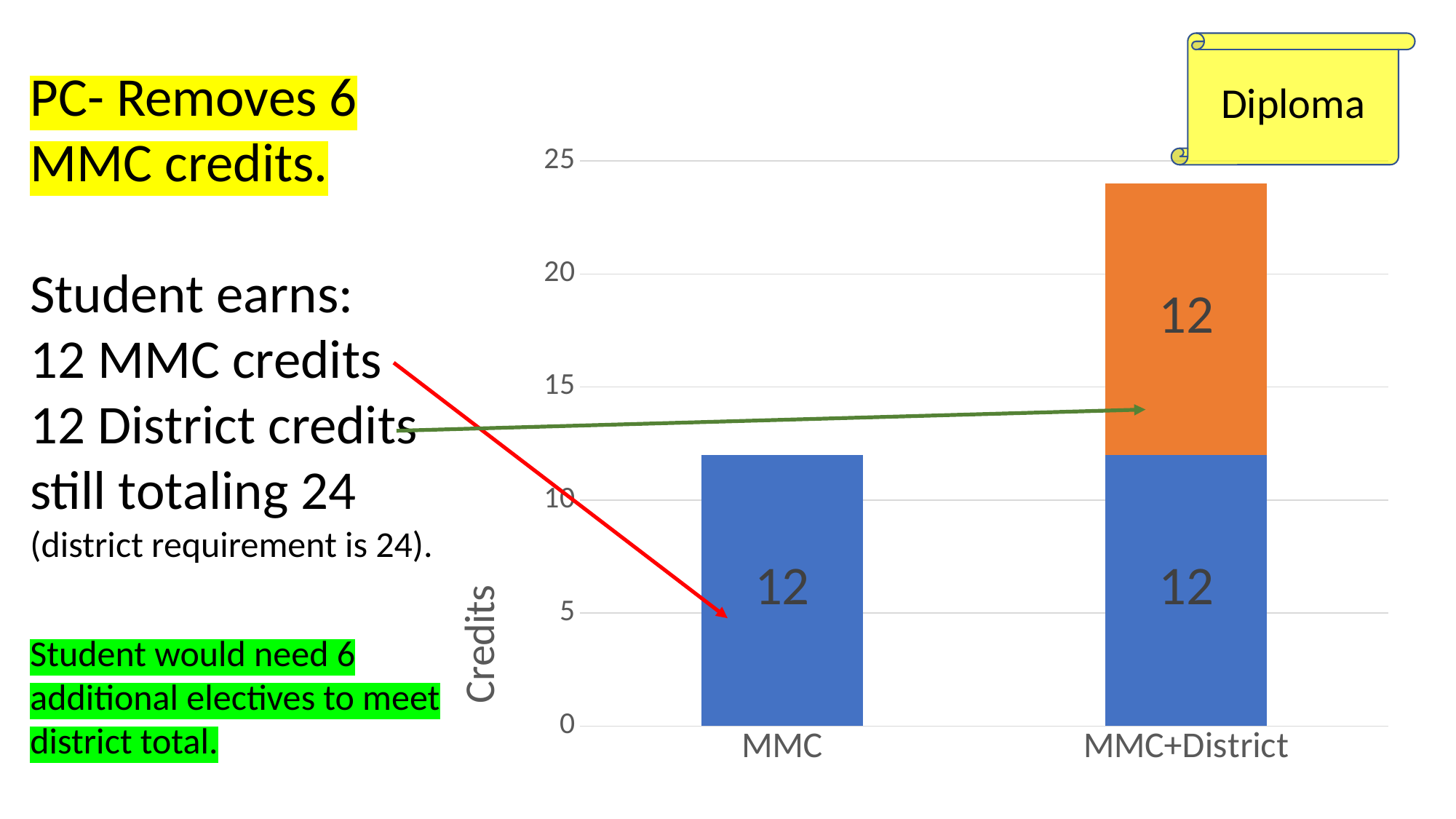
What kind of chart is shown on the slide? bar chart What is the difference between the total of the MMC+District bar and the MMC bar? 12 Is the value of the MMC bar greater or less than 15? less Which category has the taller bar overall, MMC or MMC+District? MMC+District What is the value of the blue segment for the MMC bar? 12 How many categories are shown on the x axis of the chart? 2 What is the label on the vertical axis of the chart? Credits Which category has the lowest total bar height? MMC Is the total of the MMC+District bar greater or less than 20? greater What is the value of the orange segment in the MMC+District bar? 12 What is the value of the blue segment in the MMC+District bar? 12 What is the total height of the stacked MMC+District bar? 24